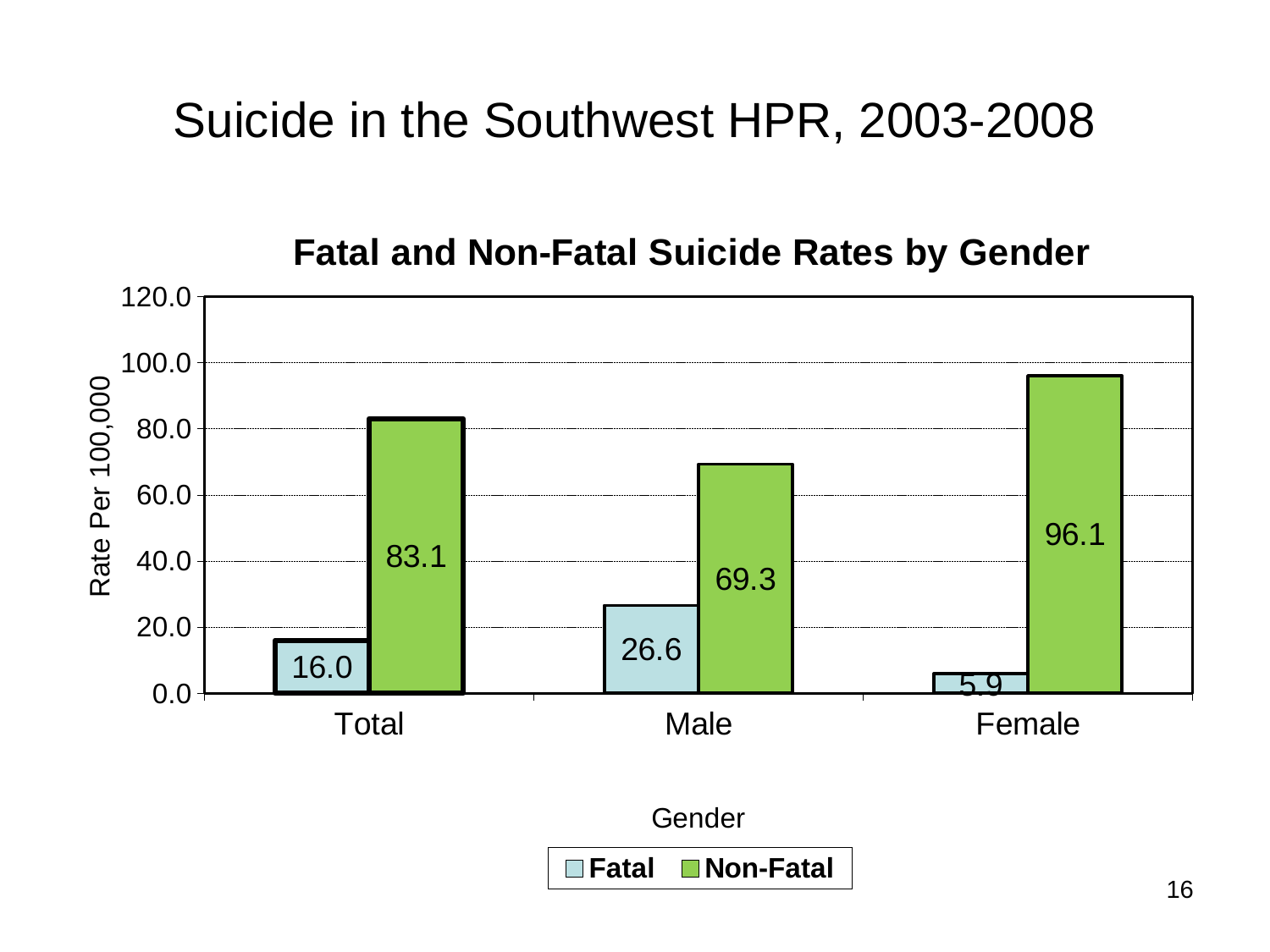
What is the Fatal suicide rate for Male? 26.6 Is the Non-Fatal rate for Male greater or less than 60.0? greater What is the Non-Fatal suicide rate for Total? 83.1 How many gender categories are shown on the x axis? 3 Which gender category has the lowest Fatal rate? Female What type of chart is shown? Bar chart How many series does the legend list? 2 Which is larger, the Fatal rate for Male or the Fatal rate for Total? Fatal rate for Male What is the difference between the Non-Fatal and Fatal rates for Male? 42.7 What is the Fatal suicide rate for Female? 5.9 What is the Non-Fatal suicide rate for Female? 96.1 Which gender category has the highest Non-Fatal rate? Female